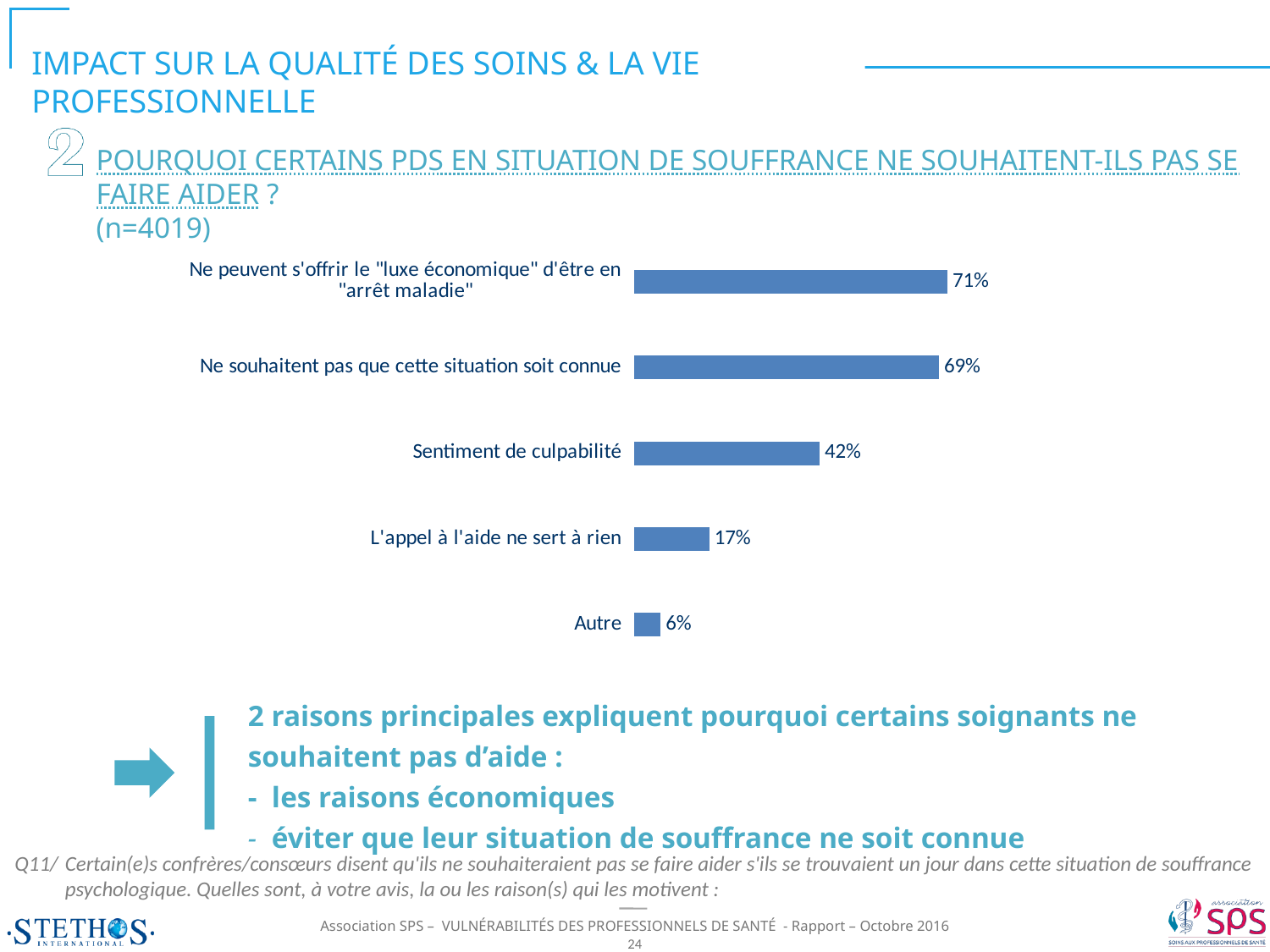
What percentage is shown for "Autre"? 6% What is the sample size (n) indicated for the chart? n=4019 What is the value for "Ne souhaitent pas que cette situation soit connue"? 69% What is the value for "L'appel à l'aide ne sert à rien"? 17% How many categories are shown in the chart? 5 Which category has the highest value? Ne peuvent s'offrir le "luxe économique" d'être en "arrêt maladie" What is the difference between the values for "Ne peuvent s'offrir le "luxe économique" d'être en "arrêt maladie"" and "Ne souhaitent pas que cette situation soit connue"? 2% Which is larger: the value for "Sentiment de culpabilité" or for "L'appel à l'aide ne sert à rien"? Sentiment de culpabilité What kind of chart is shown on the slide? Bar chart Which category has the lowest value? Autre What is the difference between "Sentiment de culpabilité" and "L'appel à l'aide ne sert à rien"? 25% What percentage is shown for "Sentiment de culpabilité"? 42%